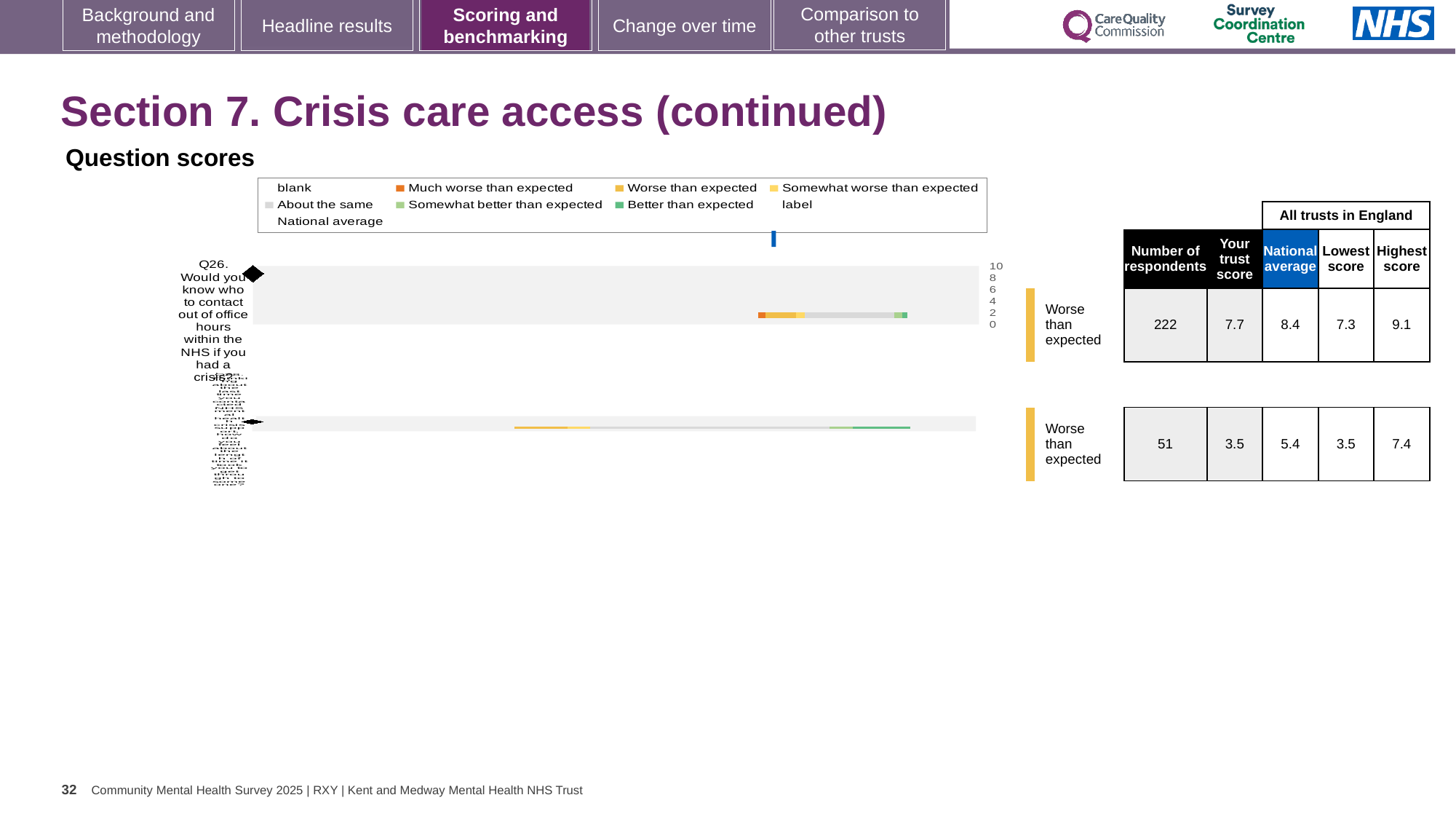
What kind of chart is used to show the question scores? bar chart How many question rows are plotted in the chart? 2 For Q26, what is the difference between the highest and lowest scores among all trusts in England? 1.8 How is the trust's Q26 score categorised relative to expectations? Worse than expected Is the trust score for Q26 greater or less than 8? less What is the trust score for Q26 (Would you know who to contact out of office hours within the NHS if you had a crisis?)? 7.7 What is the highest score among all trusts in England for Q26? 9.1 What is the lowest score among all trusts in England for Q26? 7.3 For Q26, which is larger: the trust score or the national average? National average How many respondents answered Q26? 222 What is the national average score for Q26? 8.4 For Q26, what is the difference between the national average and the trust score? 0.7